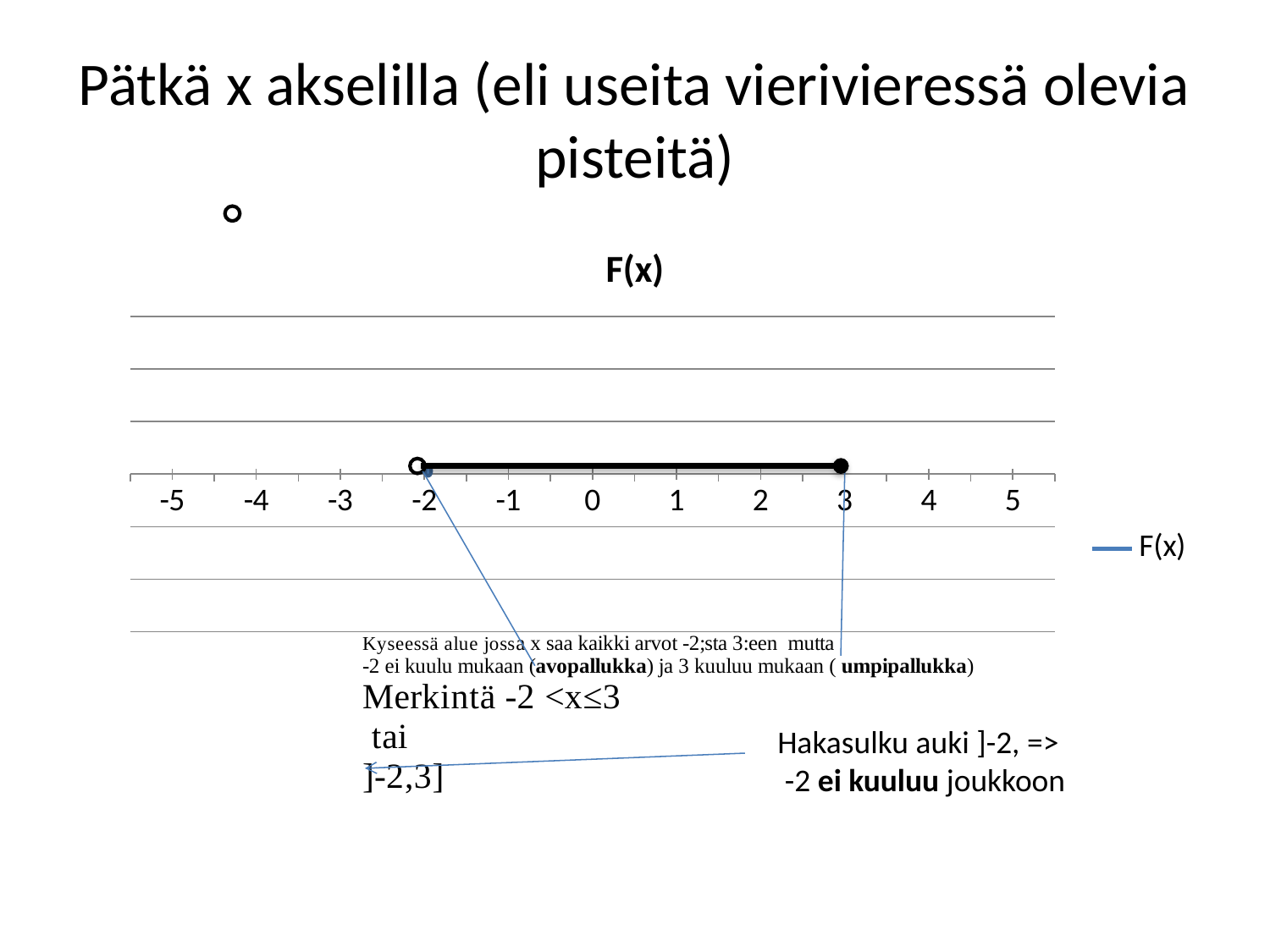
Which endpoint of the segment is drawn with an open (hollow) circle? -2 What is the title of the chart? F(x) Does the plotted line rise, fall or stay flat as x increases from -2 to 3? stay flat At what x value does the plotted segment end on the right? 3 Is the x value of the left endpoint of the segment greater or less than 0? less How many tick labels are shown on the x axis? 11 At what x value does the plotted segment begin on the left? -2 Which endpoint of the plotted segment has the larger x value, the left one or the right one? the right one (3) How many series does the chart legend list? 1 What is the difference between the right endpoint and the left endpoint of the plotted segment on the x axis? 5 Is the x value of the right endpoint of the segment greater or less than 2? greater What kind of chart is shown on the slide? line chart